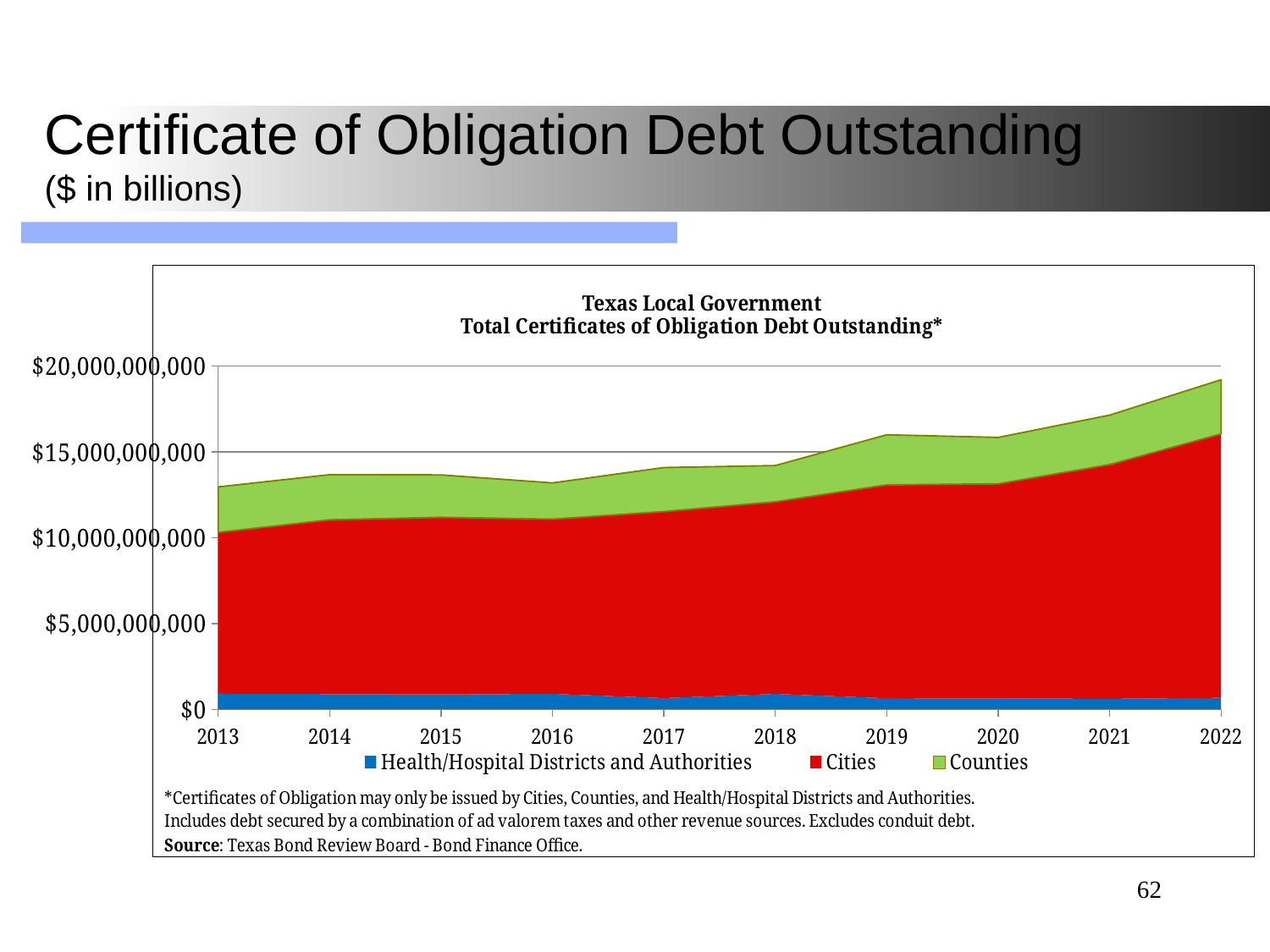
Is the total certificates of obligation debt outstanding in 2013 greater or less than $15,000,000,000? less Which series accounts for the smallest share of the total certificates of obligation debt outstanding in every year shown? Health/Hospital Districts and Authorities Is the total certificates of obligation debt outstanding in 2022 greater or less than $15,000,000,000? greater How many series does the chart's legend list? 3 Which series accounts for the largest share of the total certificates of obligation debt outstanding in every year shown? Cities What kind of chart is shown on the slide? Stacked area chart In which year is the total certificates of obligation debt outstanding highest? 2022 Is the total certificates of obligation debt outstanding in 2022 greater or less than $20,000,000,000? less Does the total certificates of obligation debt outstanding generally rise or fall from 2013 to 2022? rise Which colour represents Counties in the chart? Green What is the source cited for the chart's data? Texas Bond Review Board - Bond Finance Office How many years are plotted along the x axis of the chart? 10